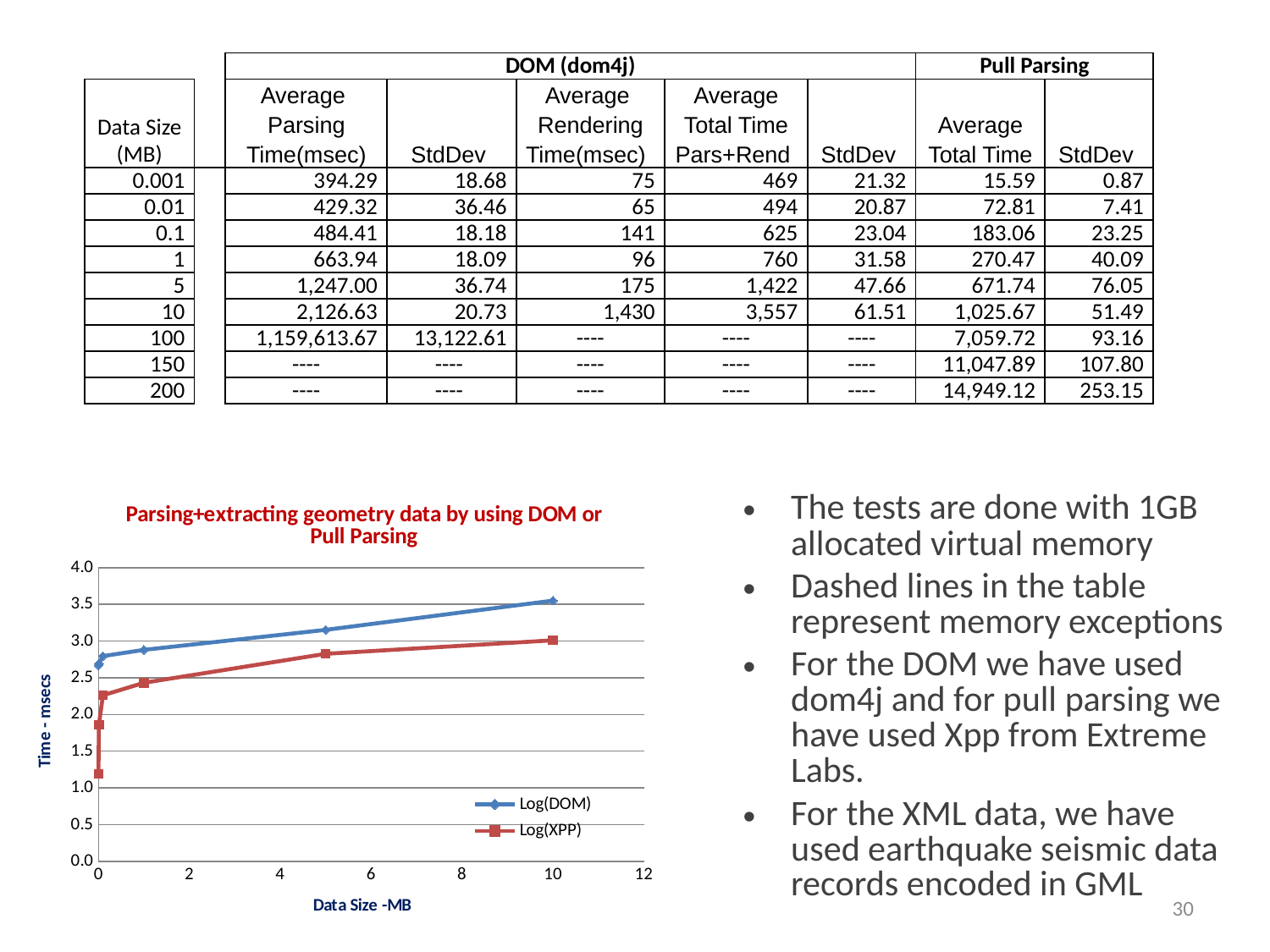
Is the Log(DOM) value at a data size of 10 MB greater or less than 3.0? greater Is the Log(XPP) value at a data size of 10 MB greater or less than 3.5? less Do the Log(XPP) values rise or fall as data size increases along the x axis? rise Do the Log(DOM) values rise or fall as data size increases along the x axis? rise At a data size of 10 MB, which series has the higher value, Log(DOM) or Log(XPP)? Log(DOM) Which series lies above the other across the whole chart, Log(DOM) or Log(XPP)? Log(DOM) Is the Log(XPP) value at a data size of 1 MB greater or less than 2.0? greater What kind of chart is shown on the slide? line chart How many series does the chart legend list? 2 What is the title of the chart? Parsing+extracting geometry data by using DOM or Pull Parsing What are the two series named in the chart legend? Log(DOM) and Log(XPP)